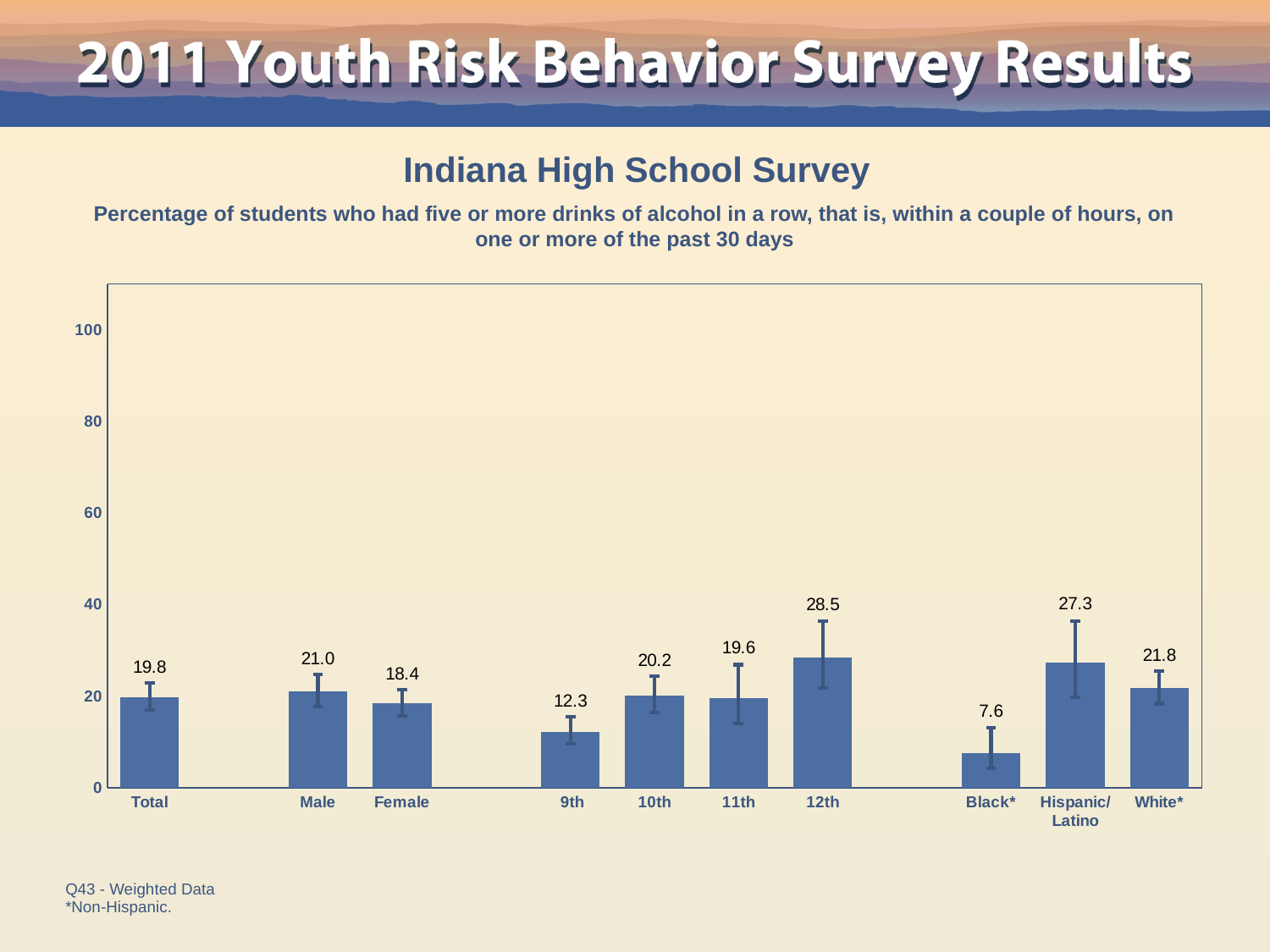
What is the difference between the 12th grade and 9th grade values? 16.2 Do the values rise or fall from 9th grade to 12th grade? rise Which category has the lowest value? Black* What is the value for Hispanic/Latino students? 27.3 What is the value for Total? 19.8 Which is larger, the value for White* or the value for Black*? White* What is the value for 12th grade? 28.5 What is the difference between the Male and Female values? 2.6 How many categories are shown on the x axis? 10 Which category has the highest value? 12th What kind of chart is this? bar chart Is the value for 12th grade greater or less than 20? greater